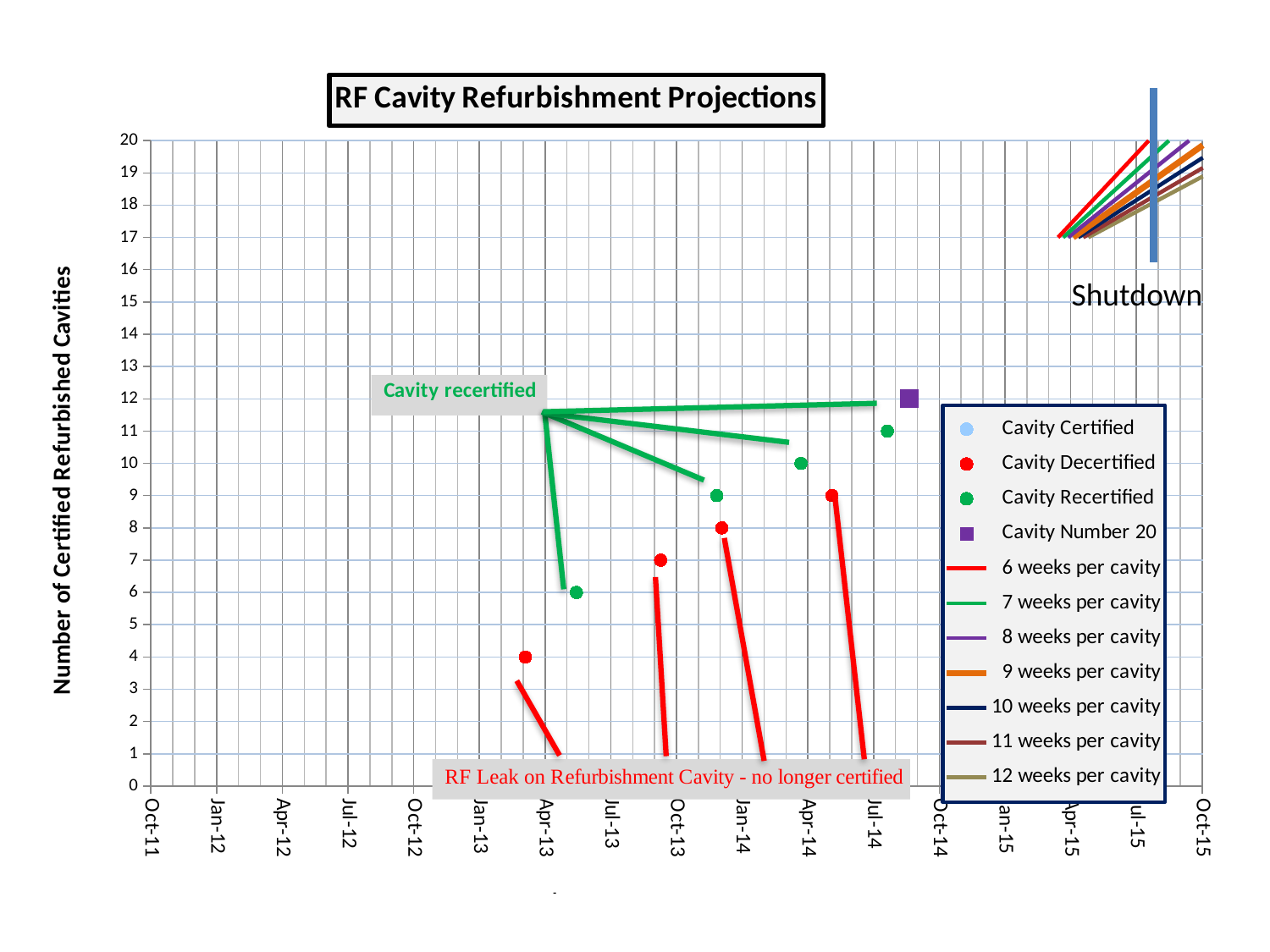
What value on the vertical axis does the Cavity Number 20 marker sit at? 12 What is the highest value among the Cavity Recertified points? 11 How many series does the legend list? 11 How many Cavity Decertified (red) points are plotted? 4 How many Cavity Recertified (green) points are plotted? 4 What kind of chart is shown on the slide? scatter chart What is the lowest value among the Cavity Decertified points? 4 What is the title of the chart? RF Cavity Refurbishment Projections At what vertical-axis value do the 'weeks per cavity' projection lines start? 17 What is the label of the vertical axis? Number of Certified Refurbished Cavities What is the highest value among the Cavity Decertified points? 9 Which is larger: the highest Cavity Recertified point or the highest Cavity Decertified point? Cavity Recertified